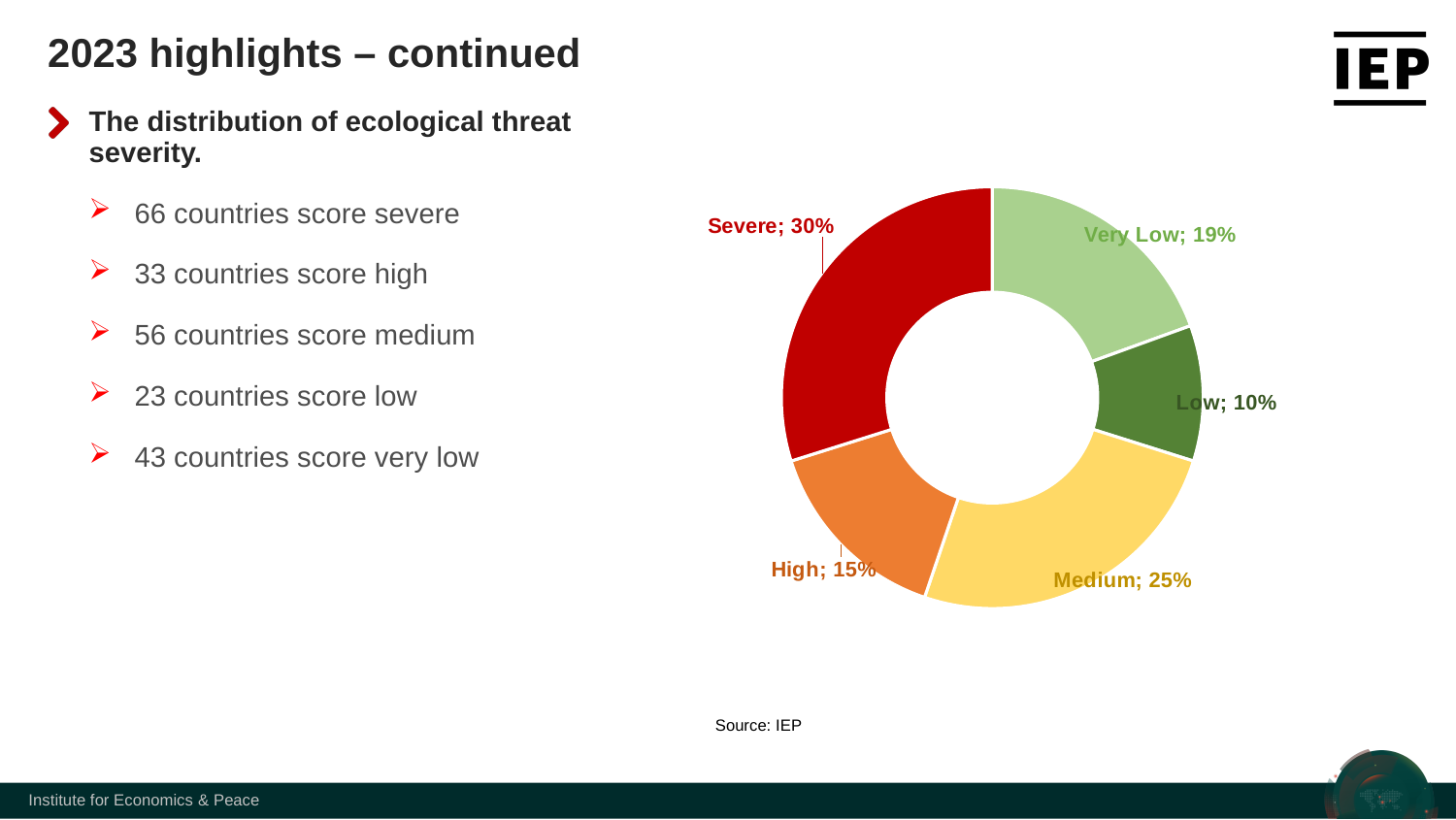
What percentage is shown for the Very Low category? 19% What percentage is shown for the Medium category? 25% What source is cited below the chart? IEP How many categories are shown in the chart? 5 Which category has the smallest share of the chart? Low What colour is the Severe segment of the chart? Red Which category has the largest share of the chart? Severe What is the difference in percentage points between the Severe and High categories? 15 What share of the chart does the Severe category represent? 30% What percentage is shown for the Low category? 10% What kind of chart is shown on the slide? Doughnut chart Which has a larger share, Medium or Very Low? Medium